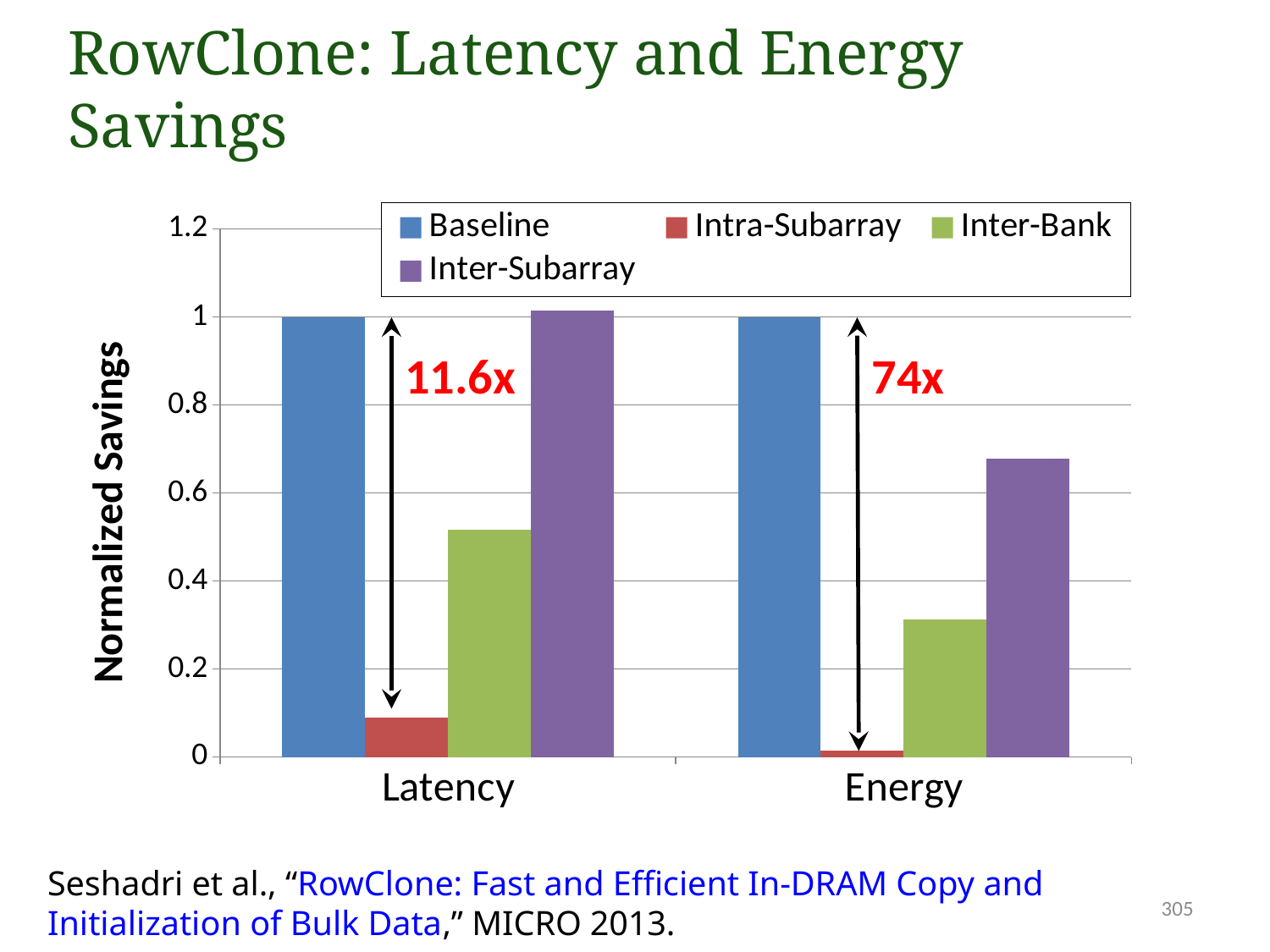
What is the Baseline value for Energy? 1 What kind of chart is shown on the slide? bar chart Is the Intra-Subarray value for Latency greater or less than 0.2? less What improvement factor is annotated above the Energy bars? 74x What is the Baseline value for Latency? 1 Which series has the lowest value for Energy? Intra-Subarray How many series does the legend list? 4 Which series has the lowest value for Latency? Intra-Subarray Is the Inter-Bank value for Latency greater or less than 0.4? greater Which is larger for Energy: Inter-Bank or Inter-Subarray? Inter-Subarray Is the Inter-Subarray value for Energy greater or less than 0.8? less How many categories are shown on the x axis? 2